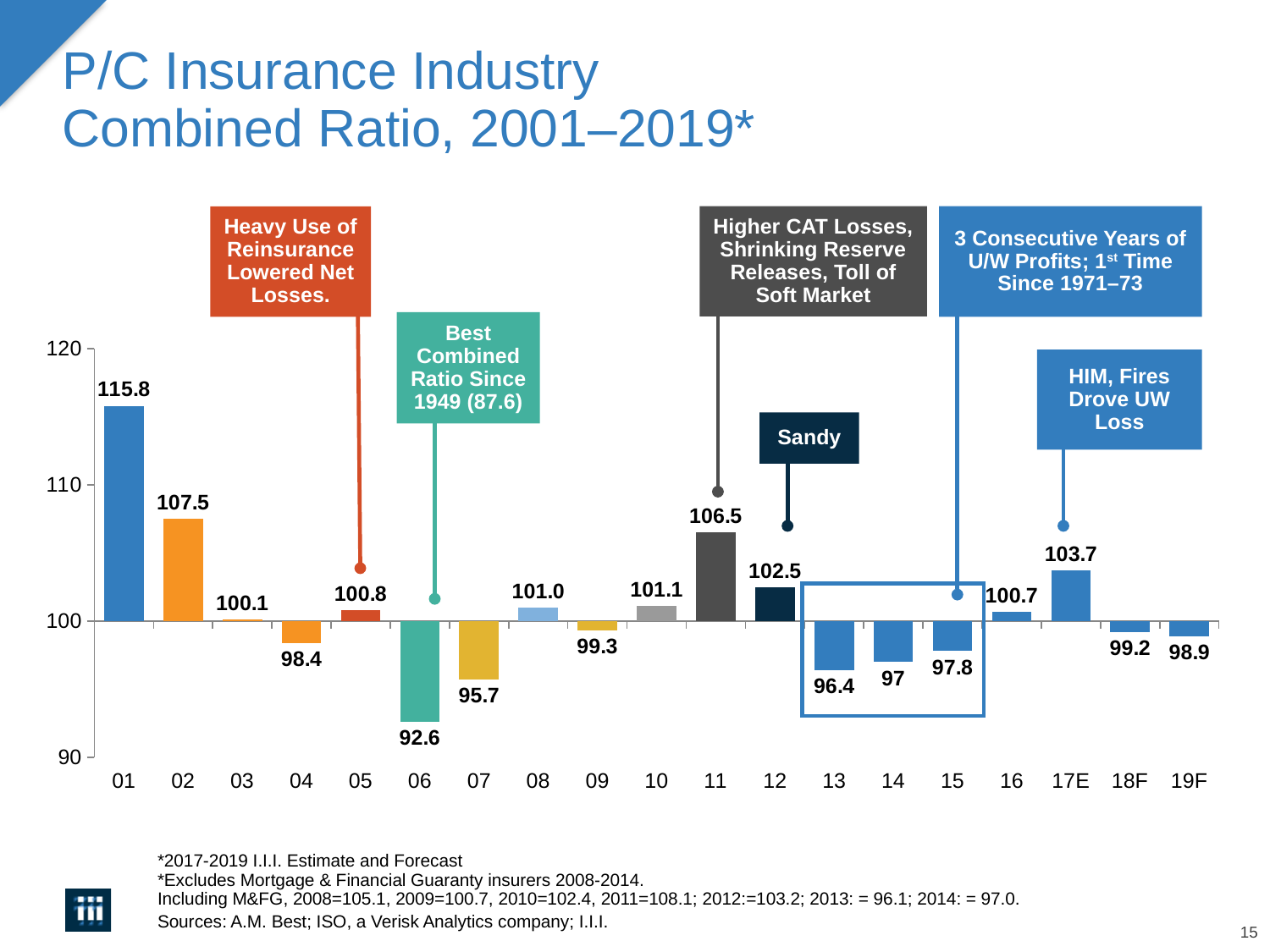
What is the difference between the combined ratio for 2011 (11) and 2012 (12)? 4.0 What kind of chart is this? bar chart How many years are shown on the x axis? 19 Do the combined ratio values rise or fall from 2013 (13) to 2015 (15)? rise Which is larger, the combined ratio for 2002 (02) or for 2011 (11)? 02 What is the combined ratio shown for 2006 (06)? 92.6 Is the combined ratio for 2007 (07) greater or less than 100? less Which year has the lowest combined ratio? 06 Which year has the highest combined ratio? 01 What is the combined ratio shown for 17E? 103.7 What is the combined ratio for 2001 (01)? 115.8 What does the callout box pointing to 2012 (12) say? Sandy